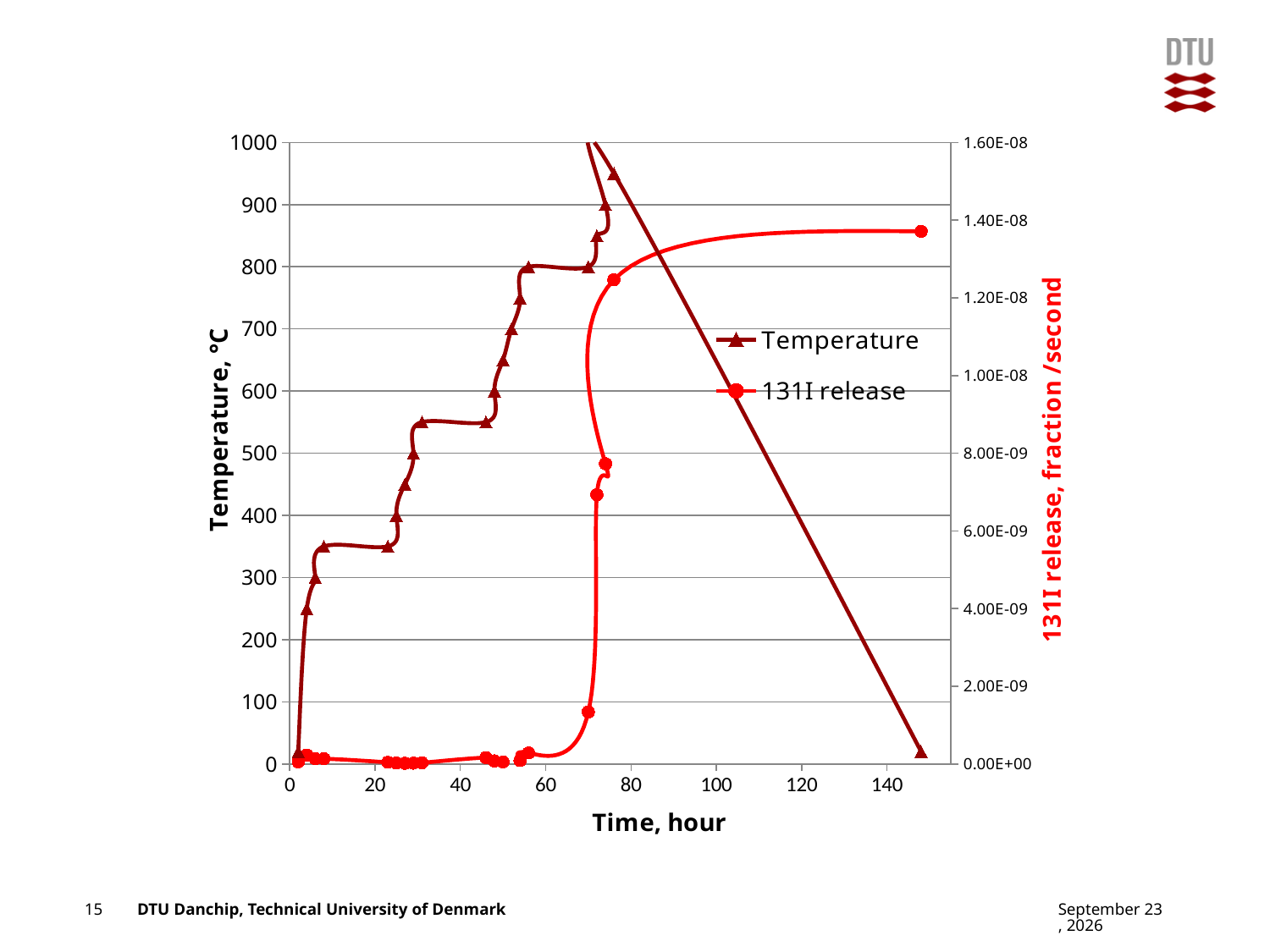
Does the 131I release series rise or fall between 60 and 80 hours? rise What is the title of the x axis? Time, hour What are the two series named in the legend? Temperature and 131I release Is the Temperature value at 120 hours greater or less than 500? less Is the Temperature value at 40 hours greater or less than 500? greater Does the Temperature series rise or fall between 80 and 140 hours? fall What kind of chart is shown on the slide? line chart Does the Temperature series rise or fall between 0 and 60 hours? rise How many series does the legend list? 2 Is the 131I release value at 140 hours greater or less than 1.20E-08? greater